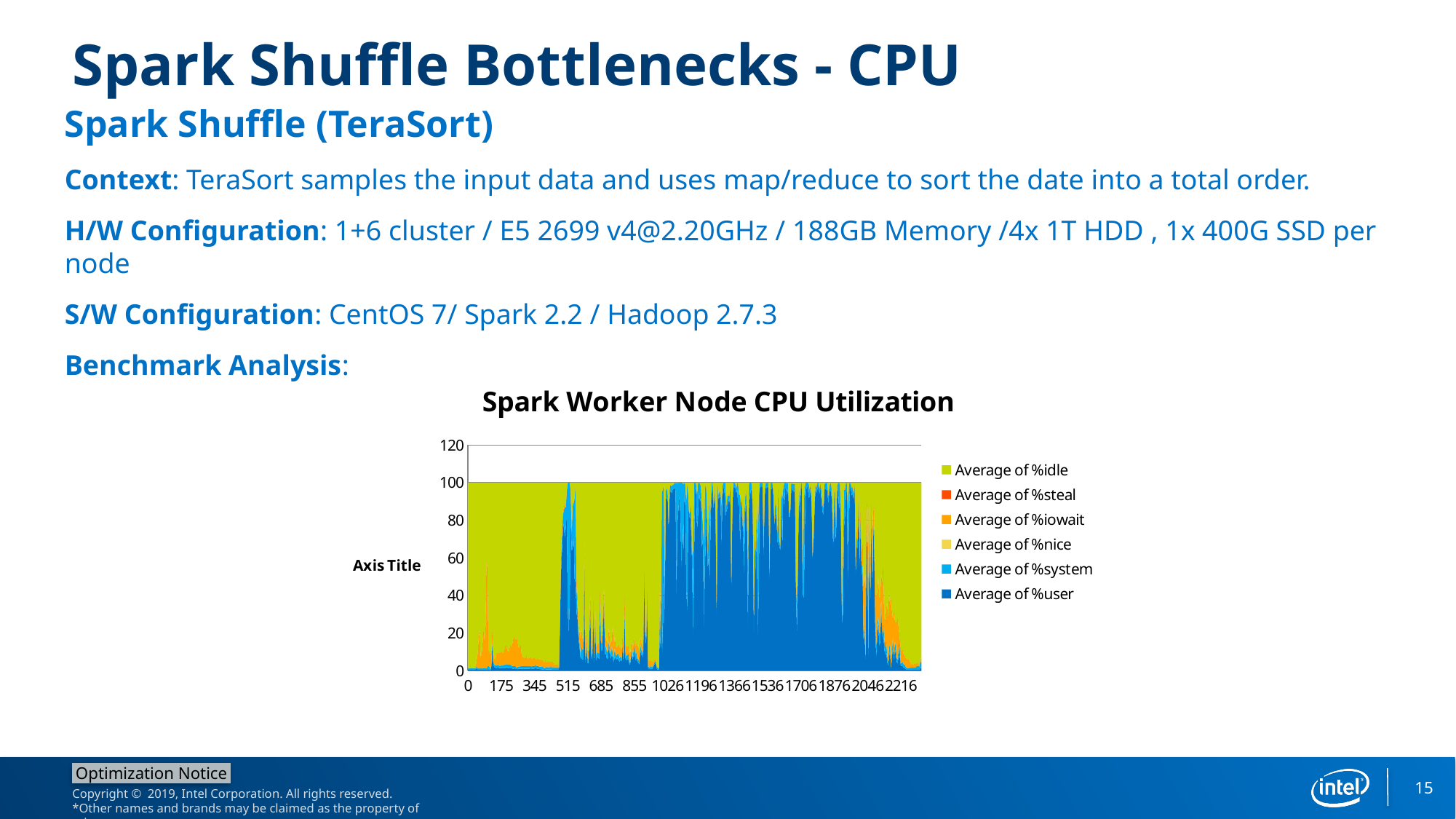
In the Spark Worker Node CPU Utilization chart, is the stacked total at x = 1366 greater or less than 80? greater What kind of chart is the Spark Worker Node CPU Utilization chart? Area chart How many tick labels are shown on the horizontal axis of the Spark Worker Node CPU Utilization chart? 14 What is the highest tick value shown on the vertical axis of the Spark Worker Node CPU Utilization chart? 120 What is the title of the chart on the slide? Spark Worker Node CPU Utilization Which series in the Spark Worker Node CPU Utilization chart is shown in green? Average of %idle What is the last tick label on the horizontal axis of the Spark Worker Node CPU Utilization chart? 2216 How many series does the legend of the Spark Worker Node CPU Utilization chart list? 6